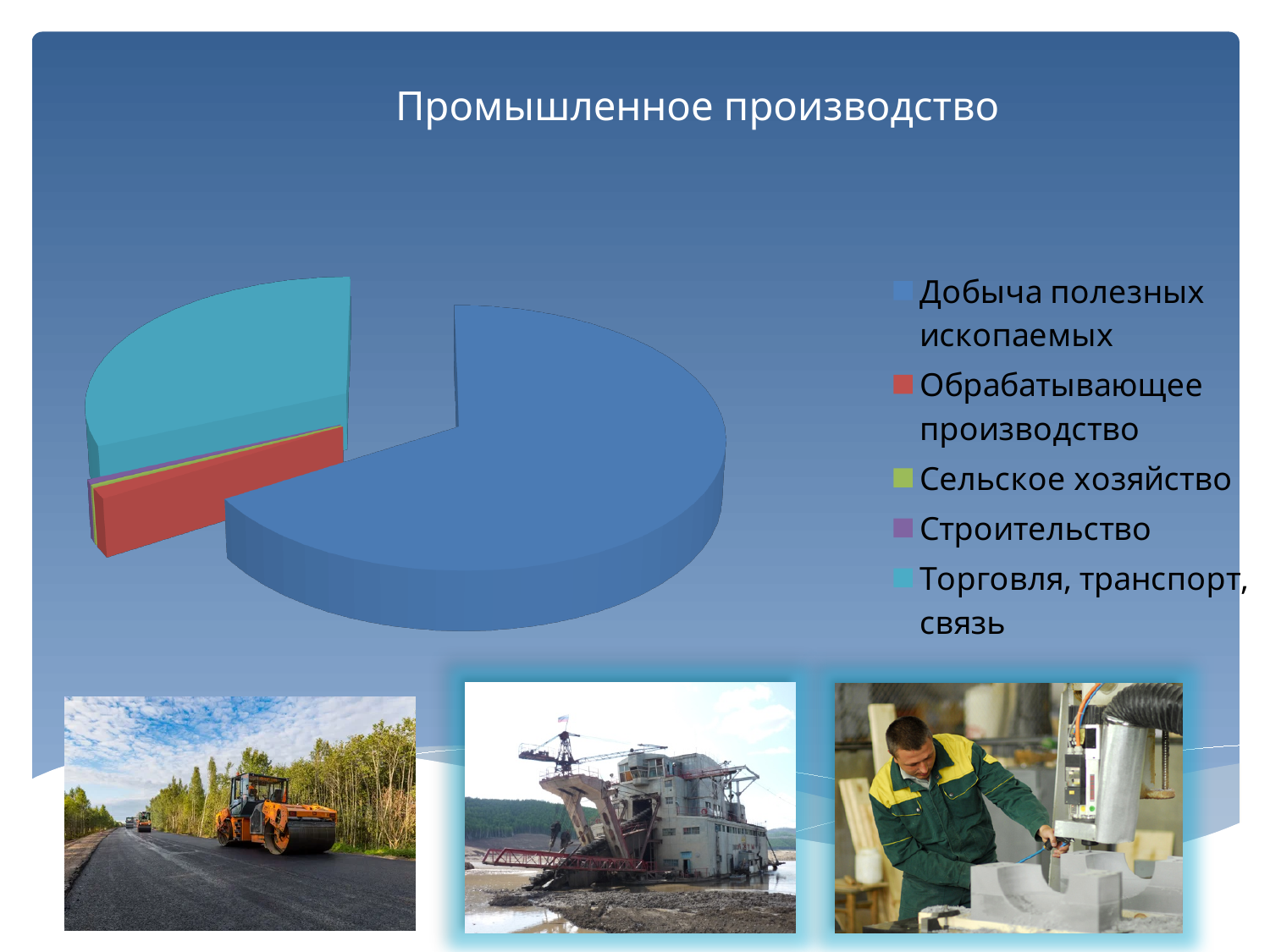
Which slice is larger: Добыча полезных ископаемых or Торговля, транспорт, связь? Добыча полезных ископаемых Which slice is larger: Торговля, транспорт, связь or Обрабатывающее производство? Торговля, транспорт, связь Which slice is larger: Обрабатывающее производство or Сельское хозяйство? Обрабатывающее производство Which category has the largest slice of the pie? Добыча полезных ископаемых What kind of chart is shown on the slide? Pie chart Which category is shown in the legend with a light blue (teal) colour? Торговля, транспорт, связь What colour is the slice for Обрабатывающее производство? Red What is the title of the chart? Промышленное производство How many categories does the pie chart have? 5